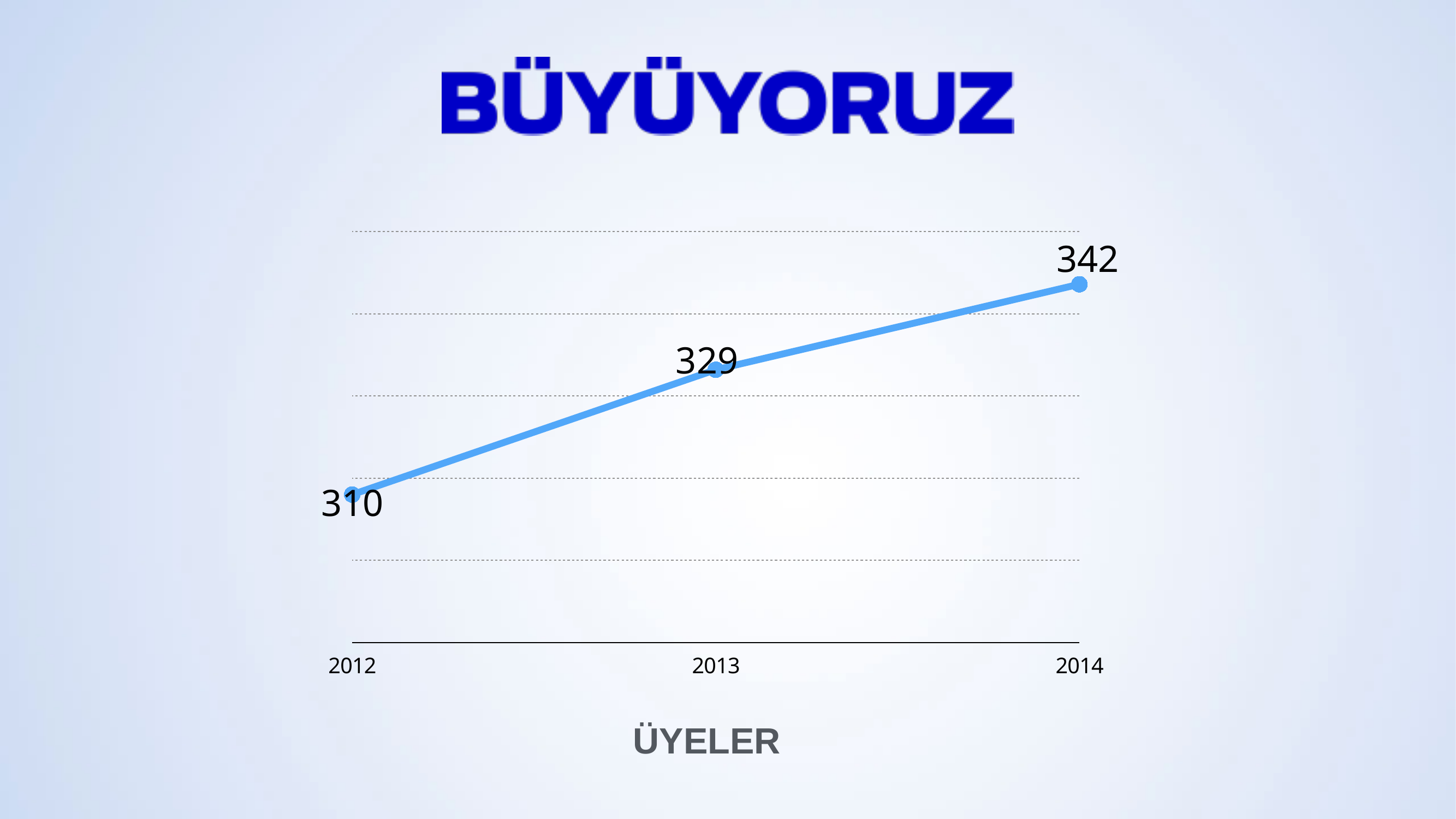
What is the title shown above the chart? BÜYÜYORUZ What is the value for 2014? 342 What is the value for 2013? 329 Which year has the highest value? 2014 Which is larger, the value for 2013 or the value for 2014? 2014 What is the difference between the values for 2013 and 2012? 19 Do the values rise or fall from 2012 to 2014? rise What is the value for 2012? 310 What is the difference between the values for 2014 and 2012? 32 What kind of chart is shown on the slide? line chart How many data points are plotted on the chart? 3 Which year has the lowest value? 2012